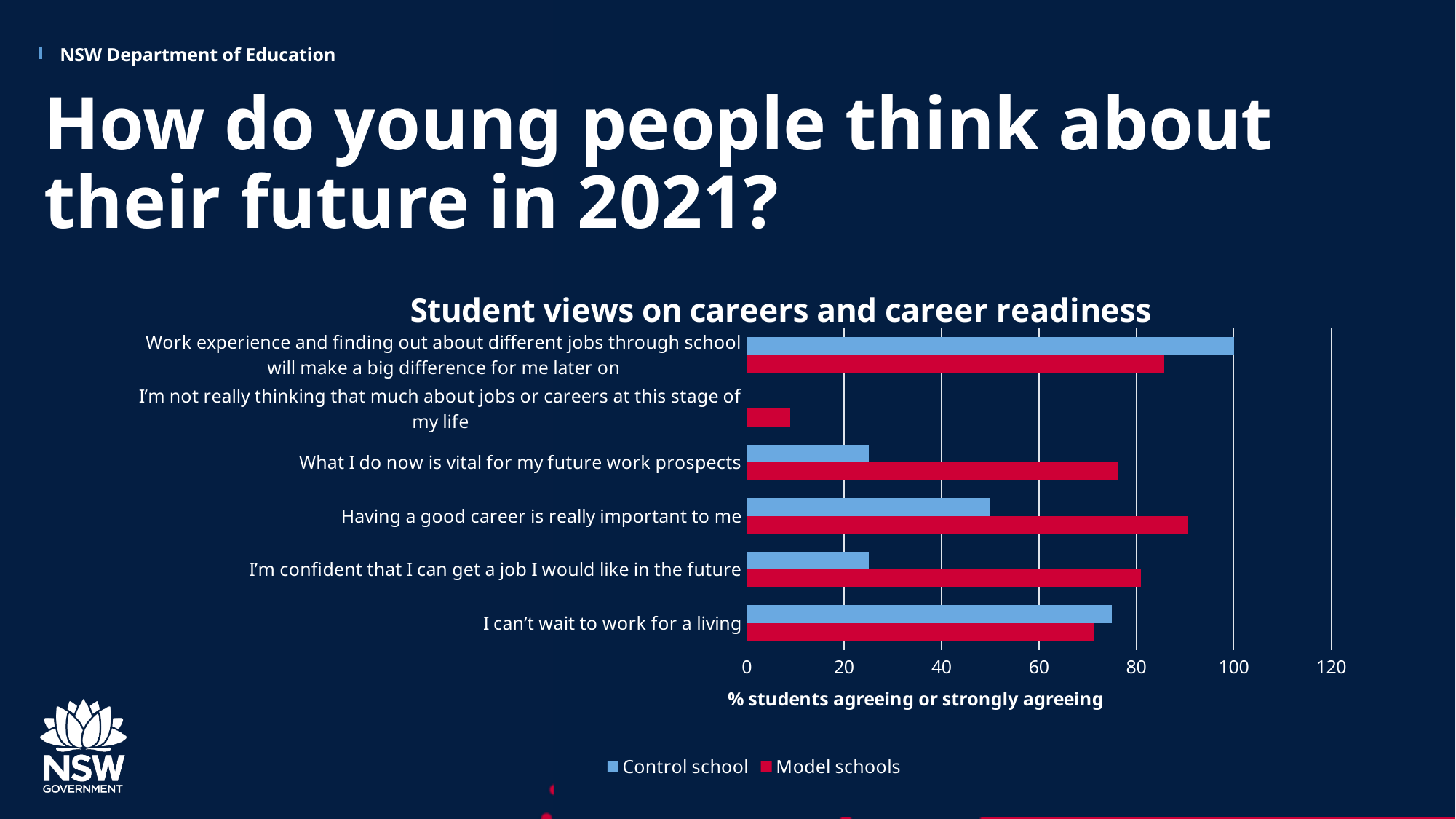
What kind of chart is shown on the slide? bar chart What is the Control school value for 'Work experience and finding out about different jobs through school will make a big difference for me later on'? 100 Which statement has the highest Model schools value? Having a good career is really important to me For 'I'm confident that I can get a job I would like in the future', which series has the larger value, Control school or Model schools? Model schools Is the Control school value for 'What I do now is vital for my future work prospects' greater or less than 40? less Which statement has the lowest Model schools value? I'm not really thinking that much about jobs or careers at this stage of my life How many series does the legend list? 2 Which statement has the highest Control school value? Work experience and finding out about different jobs through school will make a big difference for me later on What is the label on the horizontal axis of the chart? % students agreeing or strongly agreeing Is the Model schools value for 'Having a good career is really important to me' greater or less than 80? greater How many statements (categories) are plotted in the chart? 6 What is the title of the chart? Student views on careers and career readiness